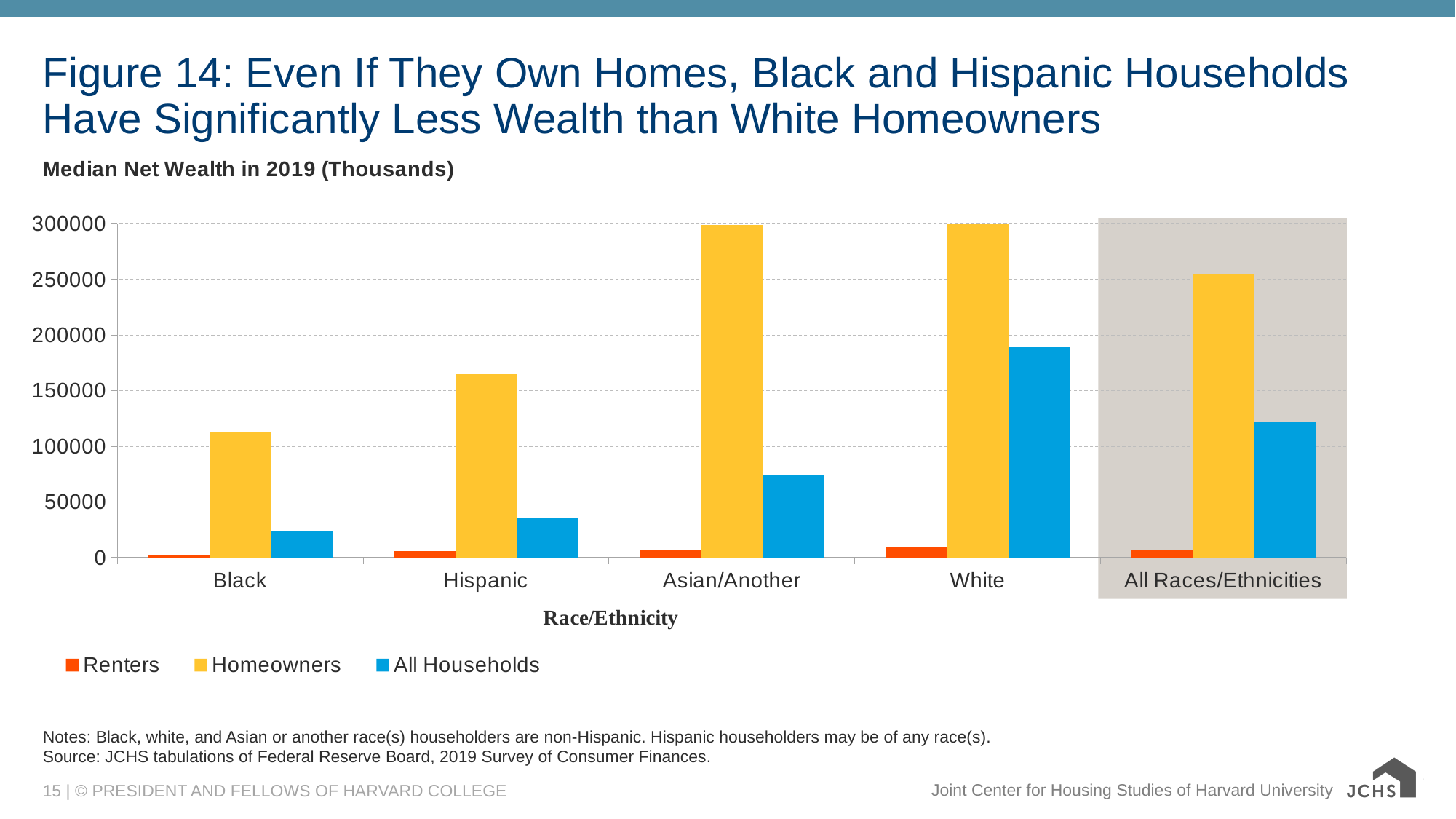
Which race/ethnicity category has the highest median net wealth for All Households? White Which race/ethnicity category has the lowest median net wealth for Homeowners? Black What kind of chart is shown on the slide? bar chart Is the Homeowners value for Black households greater or less than 100000? greater Which race/ethnicity category has the lowest median net wealth for All Households? Black Is the All Households value for White households greater or less than 200000? less What is the subtitle describing the measure plotted in the chart? Median Net Wealth in 2019 (Thousands) Is the All Households value for Asian/Another households greater or less than 100000? less Which is larger: the Homeowners value for Hispanic households or the Homeowners value for Black households? Hispanic How many race/ethnicity categories are shown on the x axis? 5 How many series does the legend list? 3